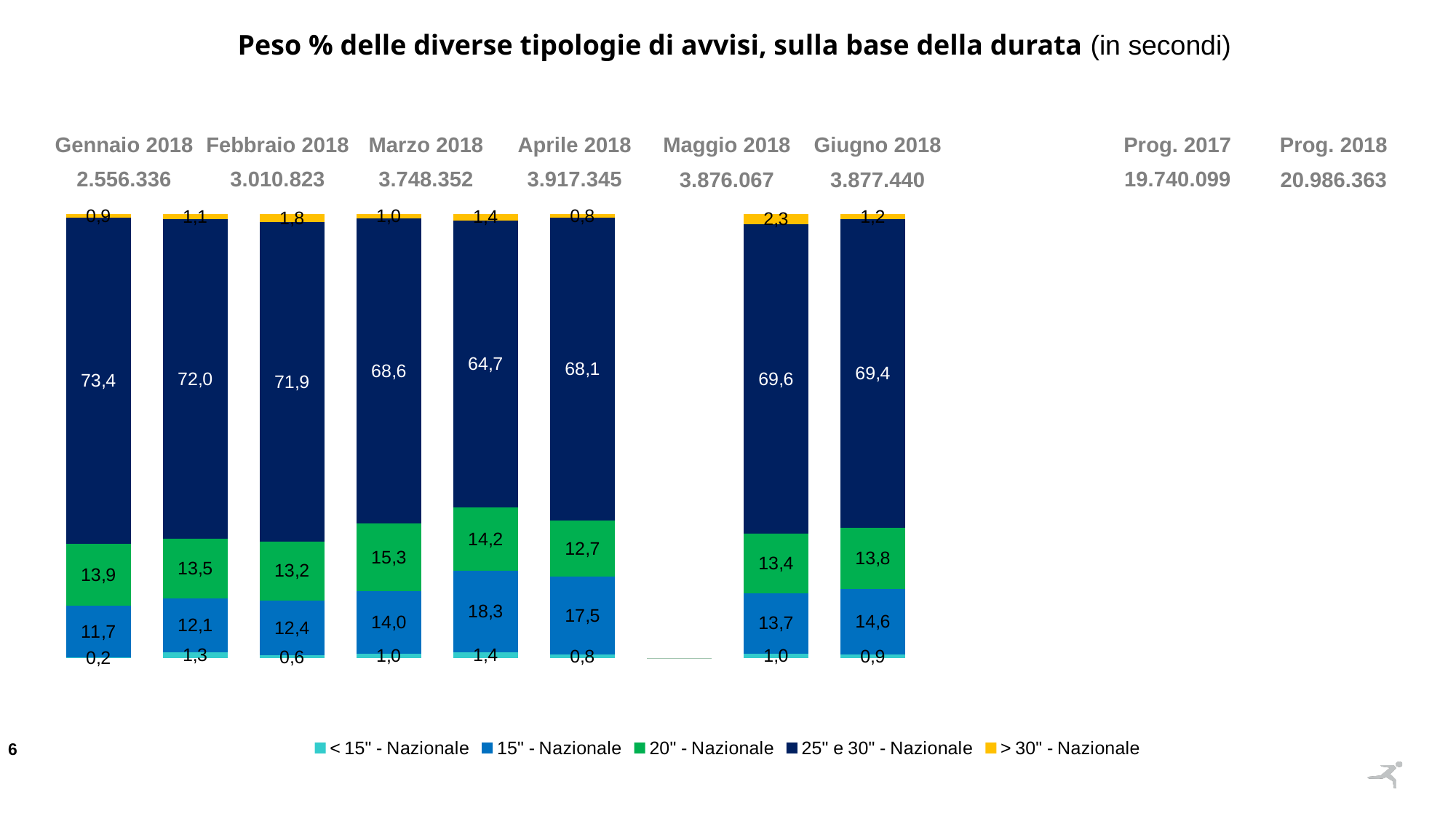
What is the value of the '25" e 30" - Nazionale' segment for Gennaio 2018? 73,4 What is the difference between the '25" e 30" - Nazionale' values for Gennaio 2018 and Maggio 2018? 8,7 How many series does the legend list? 5 Which period has the lowest '25" e 30" - Nazionale' share? Maggio 2018 What total duration in seconds is shown under Prog. 2018? 20.986.363 Which period has the highest '25" e 30" - Nazionale' share? Gennaio 2018 What is the value of the '15" - Nazionale' segment for Maggio 2018? 18,3 Which period has the highest '15" - Nazionale' share? Maggio 2018 How many bars (periods) are plotted in the chart? 8 What kind of chart is shown on the slide? Stacked bar chart Which has the larger '20" - Nazionale' share, Marzo 2018 or Aprile 2018? Aprile 2018